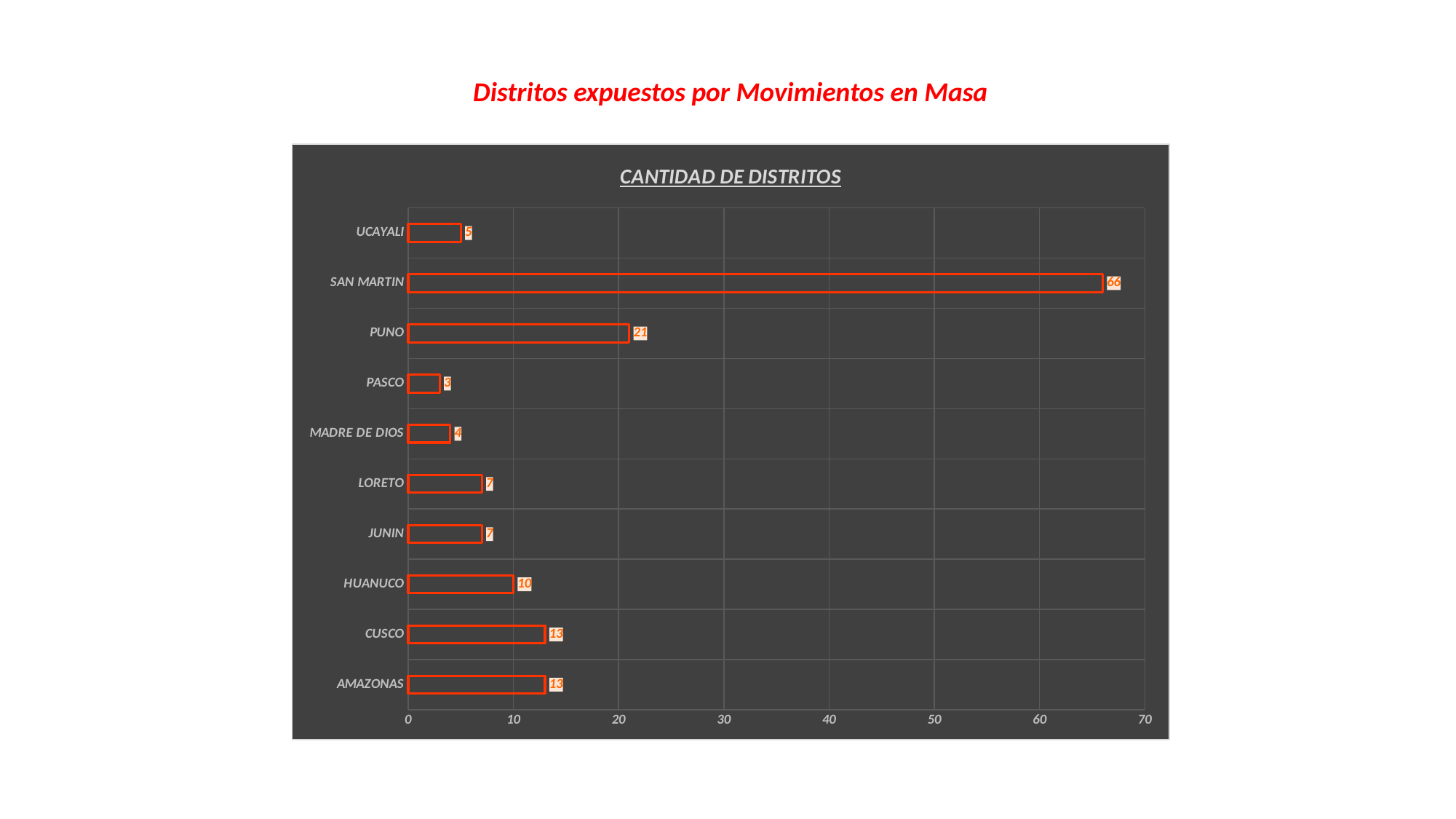
What is the value for PUNO? 21 What is the value for SAN MARTIN? 66 What is the title of the chart? CANTIDAD DE DISTRITOS Which category has the lowest value? PASCO Which category has the highest value? SAN MARTIN What is the value for MADRE DE DIOS? 4 What kind of chart is shown on the slide? bar chart Which is larger, the value for CUSCO or the value for HUANUCO? CUSCO What is the difference between the values for SAN MARTIN and PUNO? 45 How many categories are shown in the chart? 10 What is the value for HUANUCO? 10 Is the value for PUNO greater or less than 20? greater